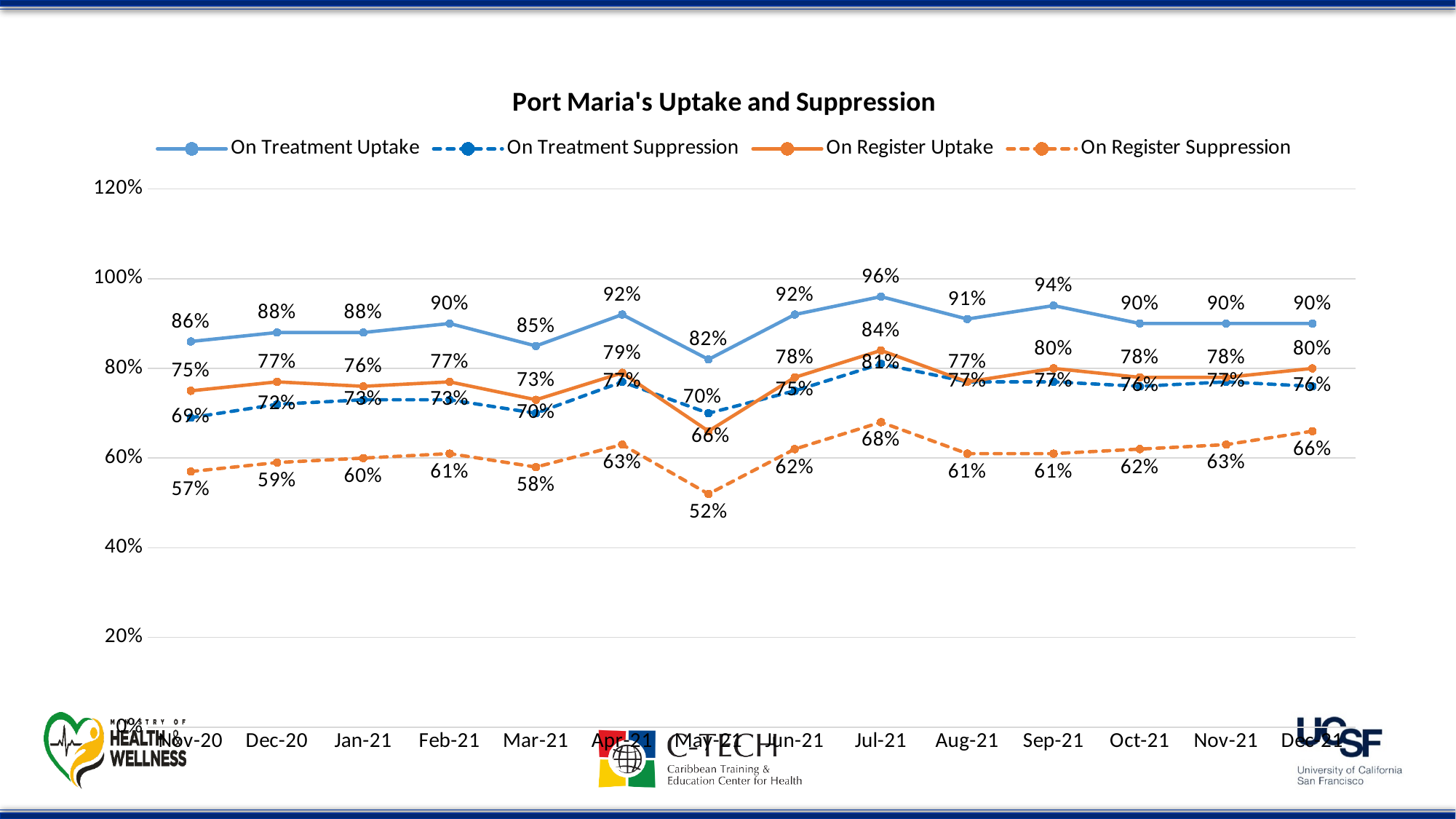
Which is larger in May-21: On Treatment Suppression or On Register Uptake? On Treatment Suppression In which month does On Treatment Uptake reach its highest value? Jul-21 What is the On Treatment Uptake value for Jul-21? 96% How many series does the legend list? 4 What is the title of the chart? Port Maria's Uptake and Suppression In which month is On Register Suppression at its lowest? May-21 What kind of chart is this? Line chart How many months are shown on the x axis? 14 What is the On Treatment Suppression value for Nov-20? 69% What is the On Register Suppression value for May-21? 52% What is the difference between On Treatment Uptake and On Register Suppression in Nov-20? 29% What is the On Register Uptake value for Dec-21? 80%